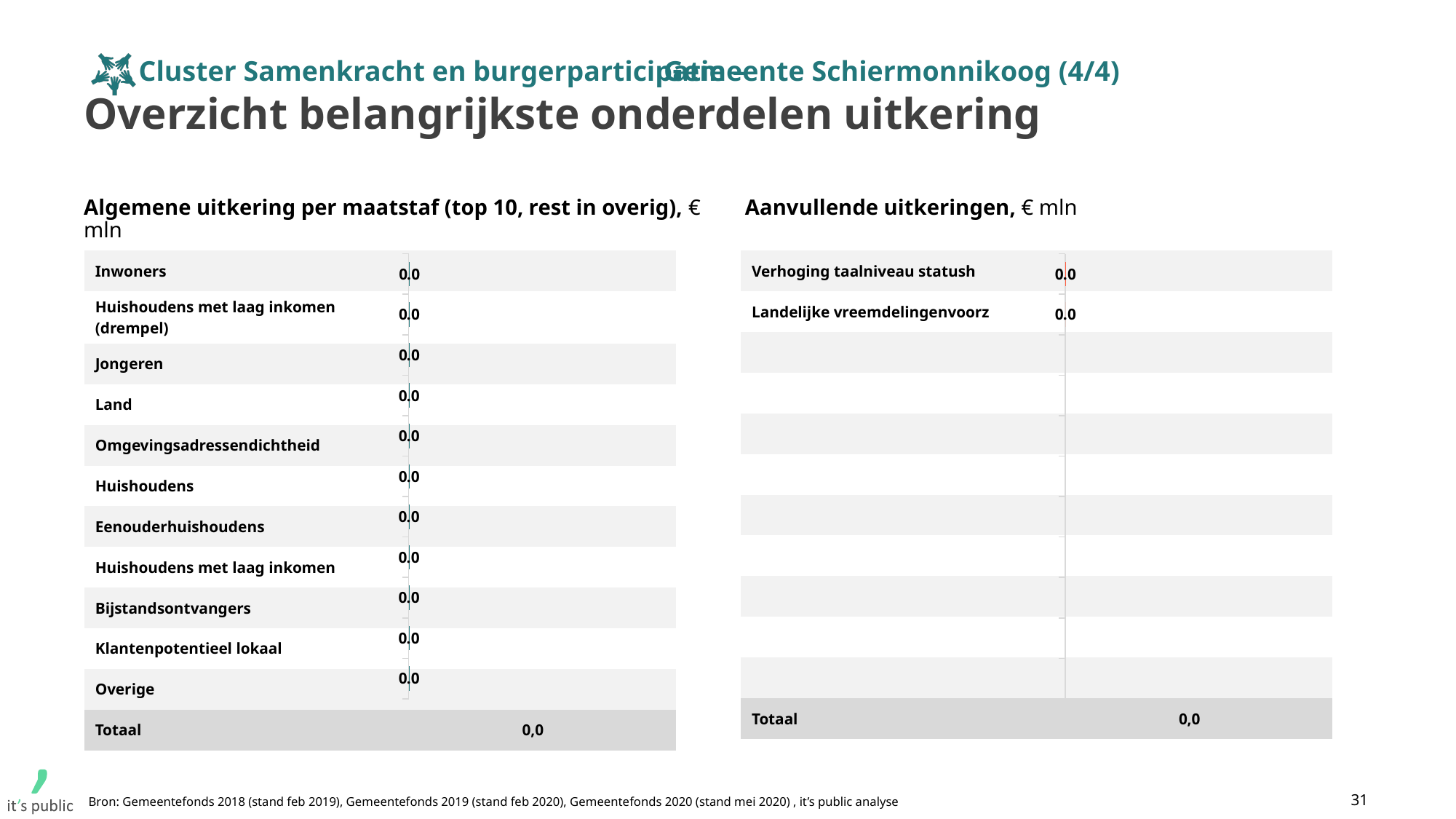
In the chart 'Aanvullende uitkeringen, € mln', how many categories are labelled? 2 In the chart 'Aanvullende uitkeringen, € mln', what is the value for Landelijke vreemdelingenvoorz? 0.0 What kind of chart is the left chart 'Algemene uitkering per maatstaf (top 10, rest in overig), € mln'? Bar chart In the chart 'Algemene uitkering per maatstaf (top 10, rest in overig), € mln', what is the value for Bijstandsontvangers? 0.0 In the chart 'Aanvullende uitkeringen, € mln', what is the Totaal value shown? 0,0 In the chart 'Algemene uitkering per maatstaf (top 10, rest in overig), € mln', how many categories are listed above the Totaal row? 11 In the chart 'Aanvullende uitkeringen, € mln', what is the value for Verhoging taalniveau statush? 0.0 What unit is stated in the title of the right chart 'Aanvullende uitkeringen'? € mln In the chart 'Algemene uitkering per maatstaf (top 10, rest in overig), € mln', what is the Totaal value shown? 0,0 In the chart 'Algemene uitkering per maatstaf (top 10, rest in overig), € mln', what is the value for Inwoners? 0.0 In the chart 'Algemene uitkering per maatstaf (top 10, rest in overig), € mln', what is the difference between the values for Jongeren and Land? 0.0 In the chart 'Algemene uitkering per maatstaf (top 10, rest in overig), € mln', what is the value for Overige? 0.0